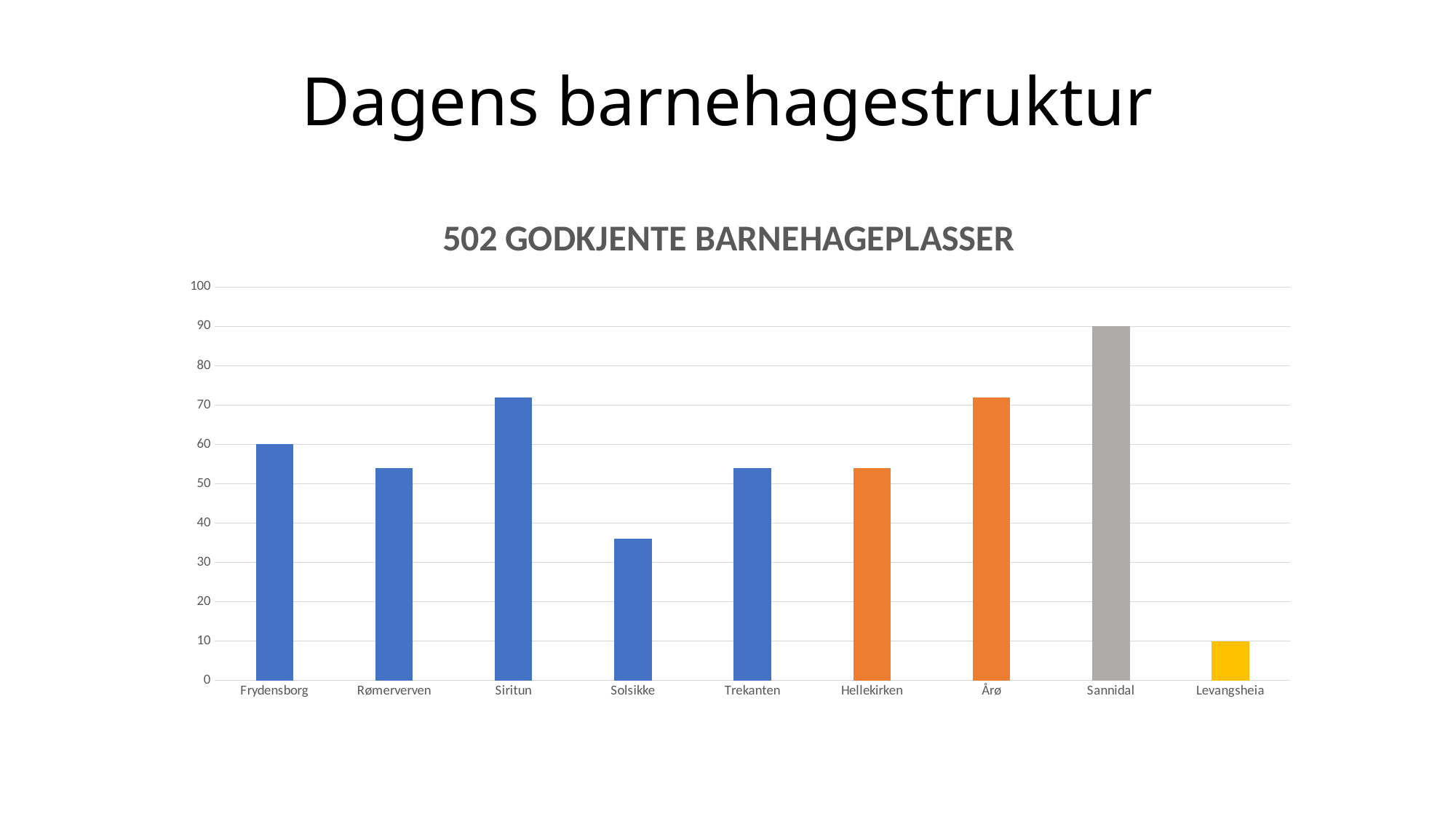
What is the value for Frydensborg? 60 How many categories are shown on the x axis? 9 Which category has the highest value? Sannidal Which is larger, the value for Siritun or the value for Solsikke? Siritun Is the value for Hellekirken greater or less than 50? greater What is the value for Sannidal? 90 Is the value for Årø greater or less than 70? greater Is the value for Solsikke greater or less than 40? less Which category has the lowest value? Levangsheia What is the difference between the values for Sannidal and Levangsheia? 80 What is the value for Levangsheia? 10 What is the title of the chart? 502 GODKJENTE BARNEHAGEPLASSER